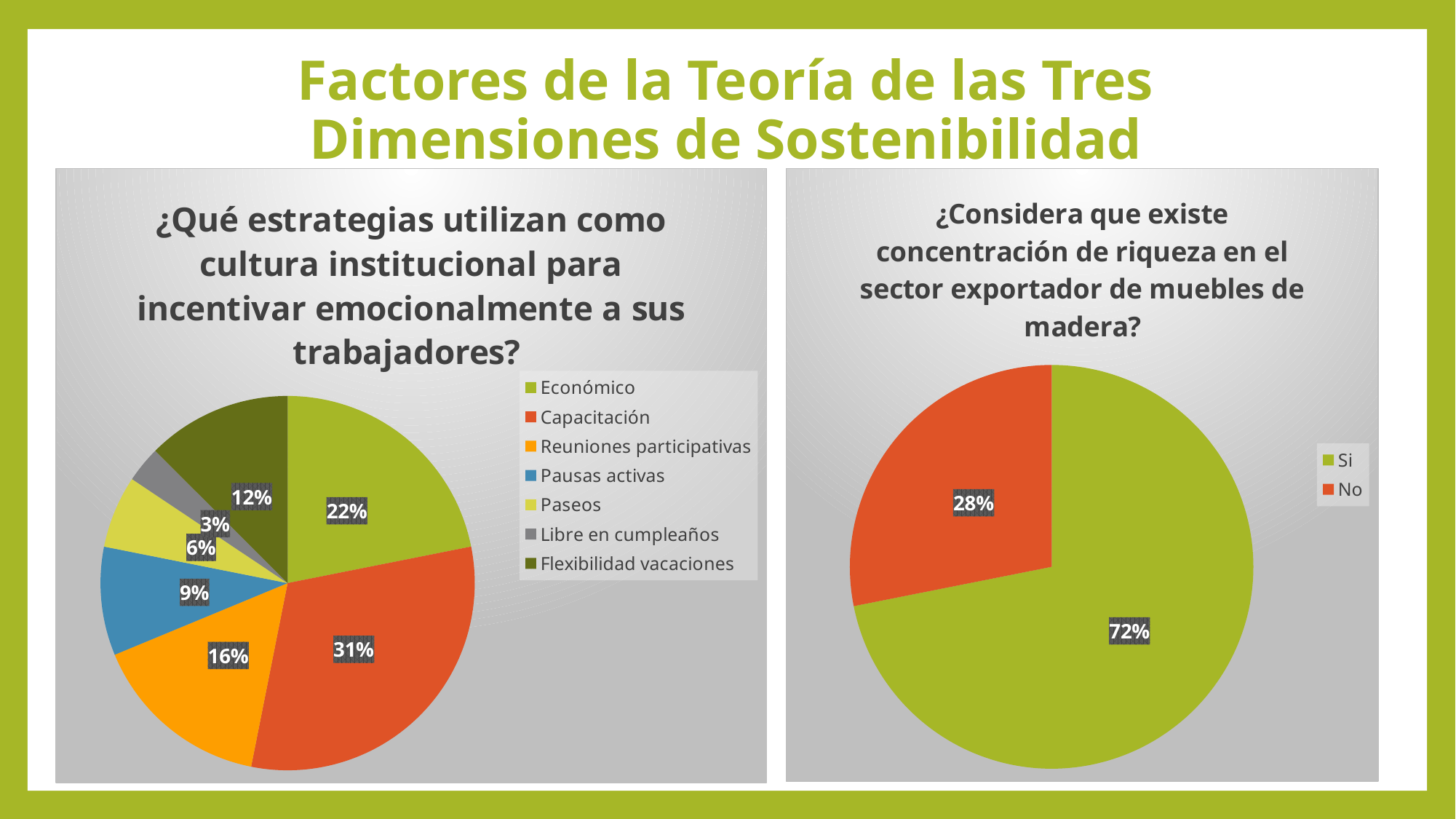
In the right chart (¿Considera que existe concentración de riqueza...?), what share answered No? 28% In the left chart (¿Qué estrategias utilizan como cultura institucional...?), what share does Capacitación have? 31% In the left chart (¿Qué estrategias utilizan como cultura institucional...?), which category has the largest slice? Capacitación In the right chart (¿Considera que existe concentración de riqueza...?), what share answered Si? 72% In the left chart (¿Qué estrategias utilizan como cultura institucional...?), what share does Pausas activas have? 9% In the left chart (¿Qué estrategias utilizan como cultura institucional...?), what is the difference between the shares of Económico and Reuniones participativas? 6% In the left chart (¿Qué estrategias utilizan como cultura institucional...?), which category has the smallest slice? Libre en cumpleaños In the left chart (¿Qué estrategias utilizan como cultura institucional...?), how many categories does the legend list? 7 What type of chart is the right chart (¿Considera que existe concentración de riqueza...?)? Pie chart In the left chart (¿Qué estrategias utilizan como cultura institucional...?), which is larger: Paseos or Flexibilidad vacaciones? Flexibilidad vacaciones In the right chart (¿Considera que existe concentración de riqueza...?), what colour is the Si slice? Green In the right chart (¿Considera que existe concentración de riqueza...?), what is the difference between the Si and No shares? 44%